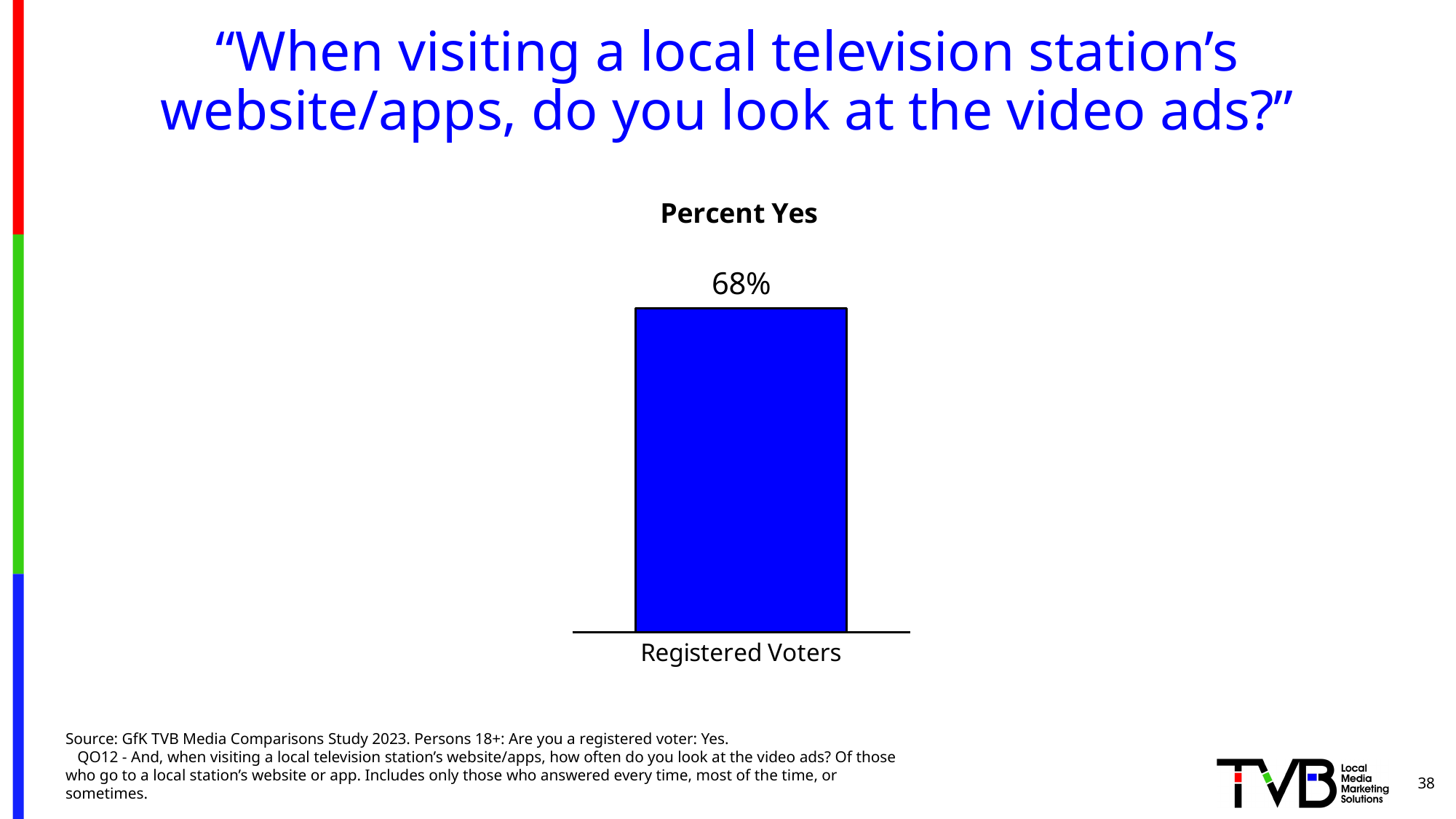
What is the value shown for Registered Voters? 68% Which category is shown on the x axis of the chart? Registered Voters What kind of chart is shown on the slide? bar chart What colour is the bar for Registered Voters? blue What is the title of the chart? Percent Yes How many categories are plotted in the chart? 1